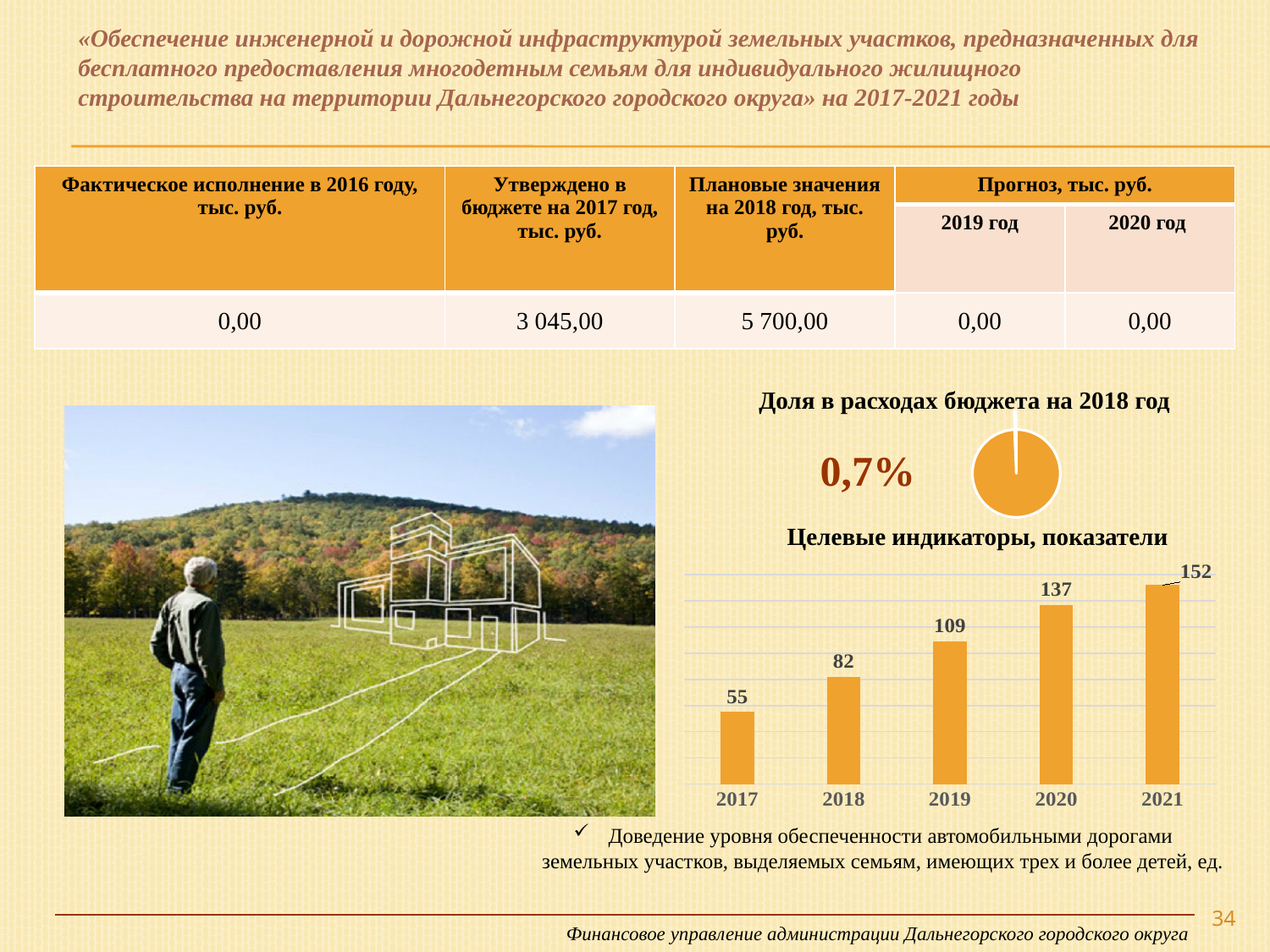
In the bar chart 'Целевые индикаторы, показатели', what is the value for 2019? 109 In the bar chart 'Целевые индикаторы, показатели', what is the difference between the values for 2020 and 2018? 55 In the bar chart 'Целевые индикаторы, показатели', what is the value for 2017? 55 In the bar chart 'Целевые индикаторы, показатели', what is the difference between the values for 2021 and 2017? 97 In the bar chart 'Целевые индикаторы, показатели', what is the value for 2021? 152 In the bar chart 'Целевые индикаторы, показатели', do the values rise or fall from 2017 to 2021? rise How many years are shown in the bar chart 'Целевые индикаторы, показатели'? 5 What share is shown next to the pie chart 'Доля в расходах бюджета на 2018 год'? 0,7% In the bar chart 'Целевые индикаторы, показатели', which year has the highest value? 2021 In the bar chart 'Целевые индикаторы, показатели', which year has the lowest value? 2017 What kind of chart is 'Целевые индикаторы, показатели'? bar chart In the bar chart 'Целевые индикаторы, показатели', which is larger, the value for 2019 or the value for 2020? 2020